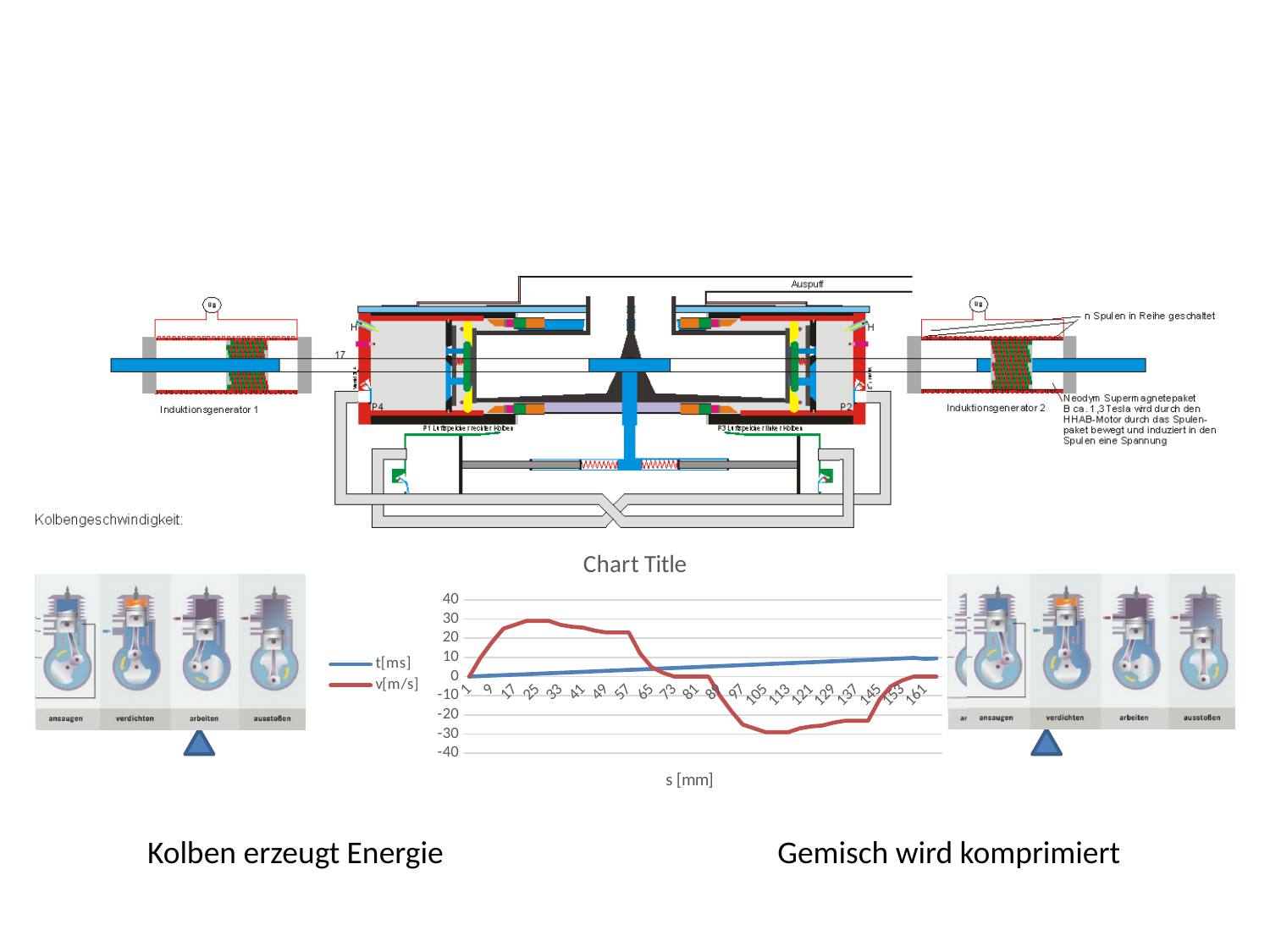
Is the value of v[m/s] at s = 105 greater or less than -20? less Is the value of v[m/s] at s = 57 greater or less than 10? greater At s = 105, which series has the higher value, t[ms] or v[m/s]? t[ms] Is the value of v[m/s] at s = 25 greater or less than 20? greater Does the v[m/s] series rise or fall between s = 57 and s = 105? fall Does the t[ms] series rise or fall as s increases along the x axis? rise What kind of chart is shown on the slide? line chart What is the label of the x axis of the chart? s [mm] At s = 25, which series has the higher value, t[ms] or v[m/s]? v[m/s] What are the two series named in the chart legend? t[ms] and v[m/s] How many series does the chart legend list? 2